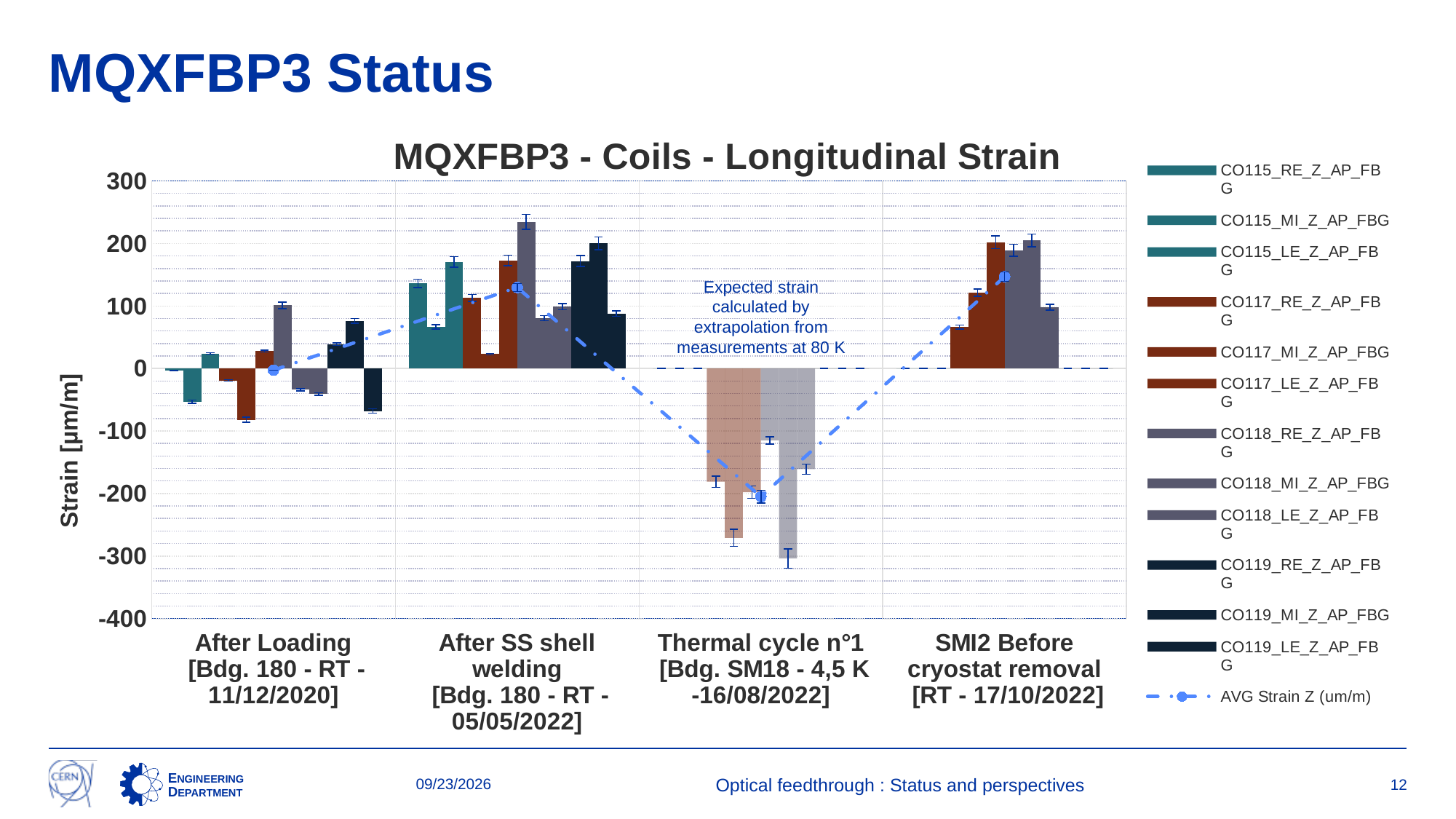
Is the AVG Strain Z (um/m) value for Thermal cycle n°1 greater or less than -100? less Is the AVG Strain Z (um/m) value for After Loading greater or less than 100? less What is the label of the vertical axis? Strain [µm/m] Is the AVG Strain Z (um/m) value for SMI2 Before cryostat removal greater or less than 100? greater Which category has the lowest value of the AVG Strain Z (um/m) line? Thermal cycle n°1 [Bdg. SM18 - 4,5 K -16/08/2022] Which is larger, the AVG Strain Z (um/m) value for After SS shell welding or for Thermal cycle n°1? After SS shell welding How many categories are shown along the x axis? 4 What kind of chart is shown on the slide? Bar chart with a line series Does the AVG Strain Z (um/m) line rise or fall from After Loading to After SS shell welding? rise What is the title of the chart? MQXFBP3 - Coils - Longitudinal Strain How many series does the legend list? 13